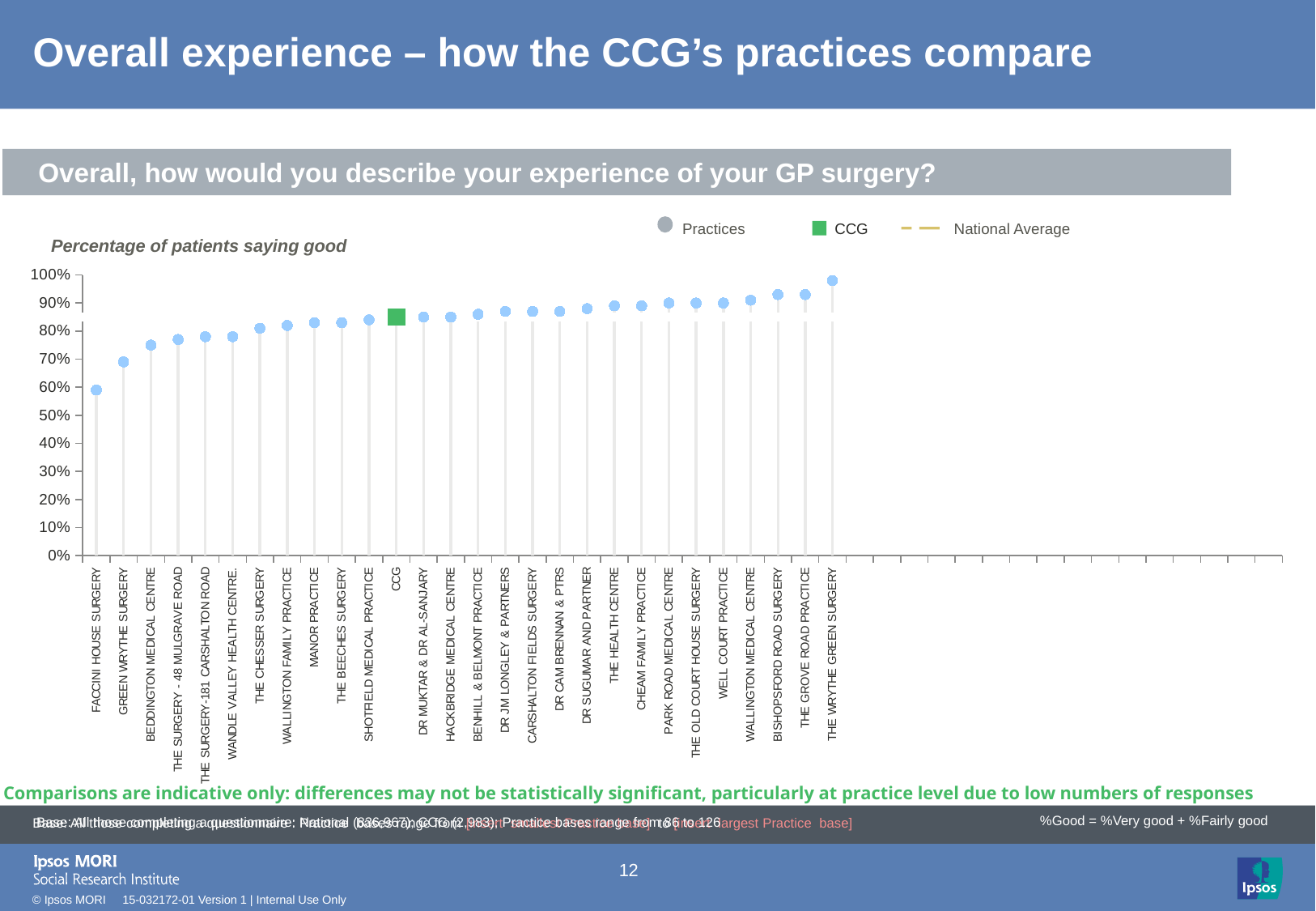
Is the value for FACCINI HOUSE SURGERY greater or less than 70%? less How many practices (excluding the CCG point) are plotted on the chart? 27 Which practice has the lowest percentage of patients saying good? FACCINI HOUSE SURGERY Is the value for THE WRYTHE GREEN SURGERY greater or less than 90%? greater Is the value for the CCG greater or less than 80%? greater Do the plotted values rise or fall from left to right along the x axis? rise How many entries does the chart legend list? 3 What is the subtitle describing the measure plotted on the chart? Percentage of patients saying good Which has a higher percentage of patients saying good: BEDDINGTON MEDICAL CENTRE or PARK ROAD MEDICAL CENTRE? PARK ROAD MEDICAL CENTRE Which practice has the highest percentage of patients saying good? THE WRYTHE GREEN SURGERY